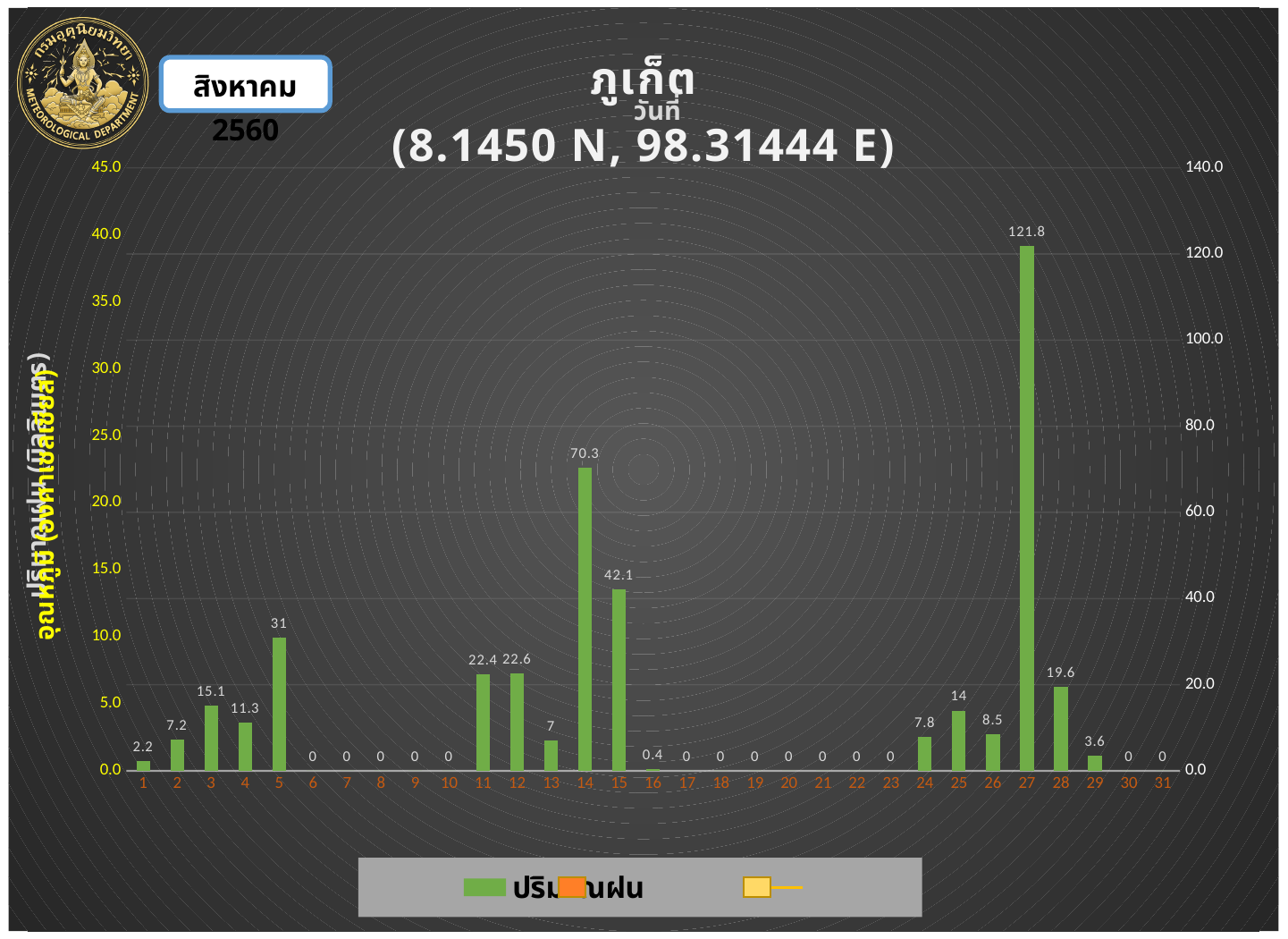
What is the total of the values for days 11, 12 and 13? 52 What is the difference between the values for day 14 and day 15? 28.2 What is the value shown for day 14? 70.3 What is the rainfall value shown for day 27? 121.8 What is the value shown for day 16? 0.4 Which is larger, the value for day 3 or the value for day 4? day 3 Which is larger, the value for day 25 or the value for day 26? day 25 What is the difference between the values for day 27 and day 28? 102.2 What kind of chart is shown on the slide? bar chart How many days are shown on the x axis? 31 Which day has the highest bar? 27 What is the value shown for day 5? 31